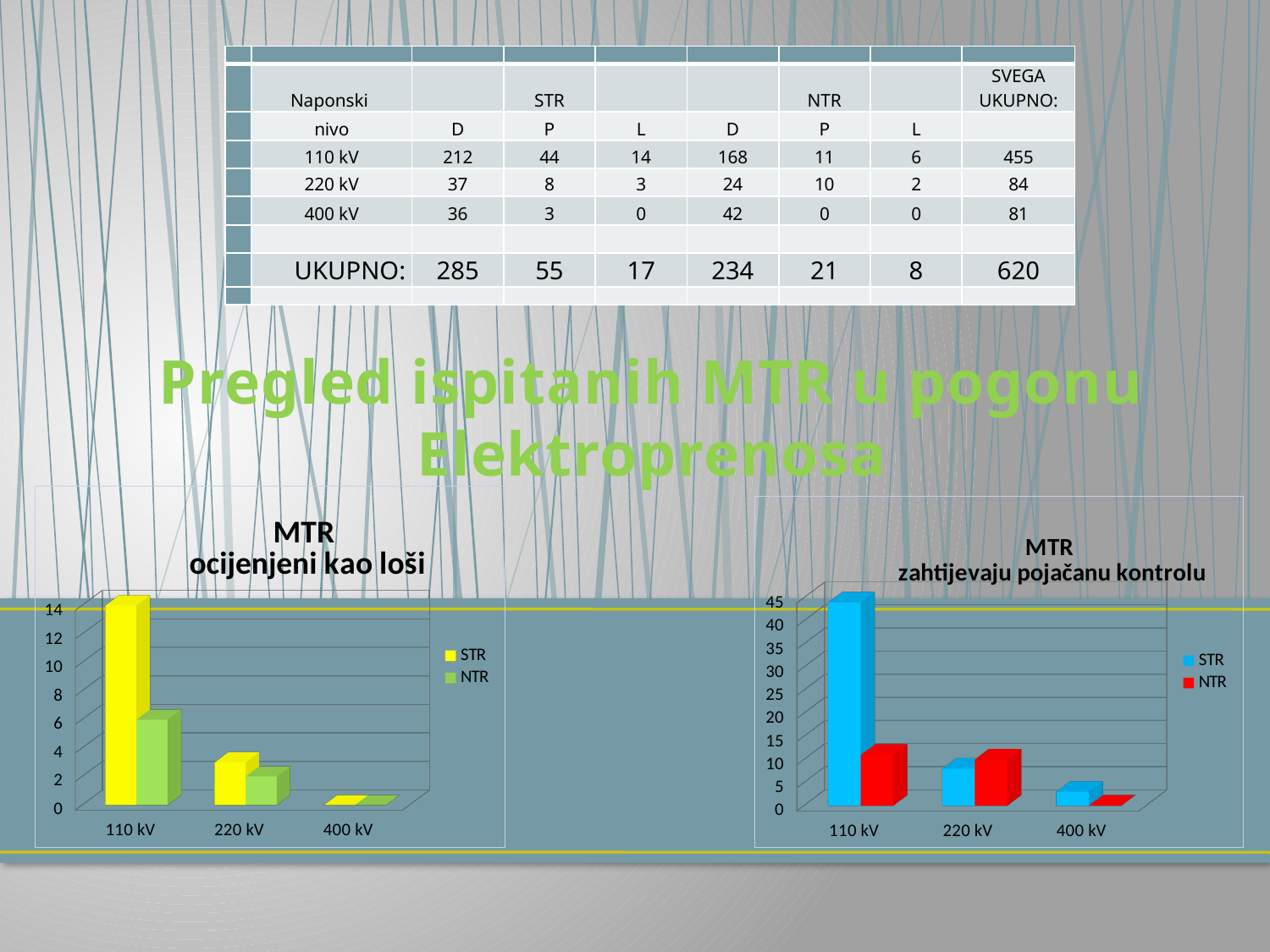
What is the title of the left chart? MTR ocijenjeni kao loši How many series does the legend of the right chart "MTR zahtijevaju pojačanu kontrolu" list? 2 In the right chart "MTR zahtijevaju pojačanu kontrolu", is the STR value for 110 kV greater or less than 40? greater In the left chart "MTR ocijenjeni kao loši", do the STR values rise or fall from 110 kV to 400 kV? fall In the left chart "MTR ocijenjeni kao loši", which category has the lowest STR value? 400 kV In the right chart "MTR zahtijevaju pojačanu kontrolu", which is larger for 110 kV, STR or NTR? STR What colour represents the NTR series in the right chart "MTR zahtijevaju pojačanu kontrolu"? red In the right chart "MTR zahtijevaju pojačanu kontrolu", which category has the highest STR value? 110 kV In the left chart "MTR ocijenjeni kao loši", is the STR value for 110 kV greater or less than 12? greater How many categories are shown on the x axis of the left chart "MTR ocijenjeni kao loši"? 3 In the left chart "MTR ocijenjeni kao loši", is the NTR value for 110 kV greater or less than 8? less What kind of chart is the left chart titled "MTR ocijenjeni kao loši"? bar chart